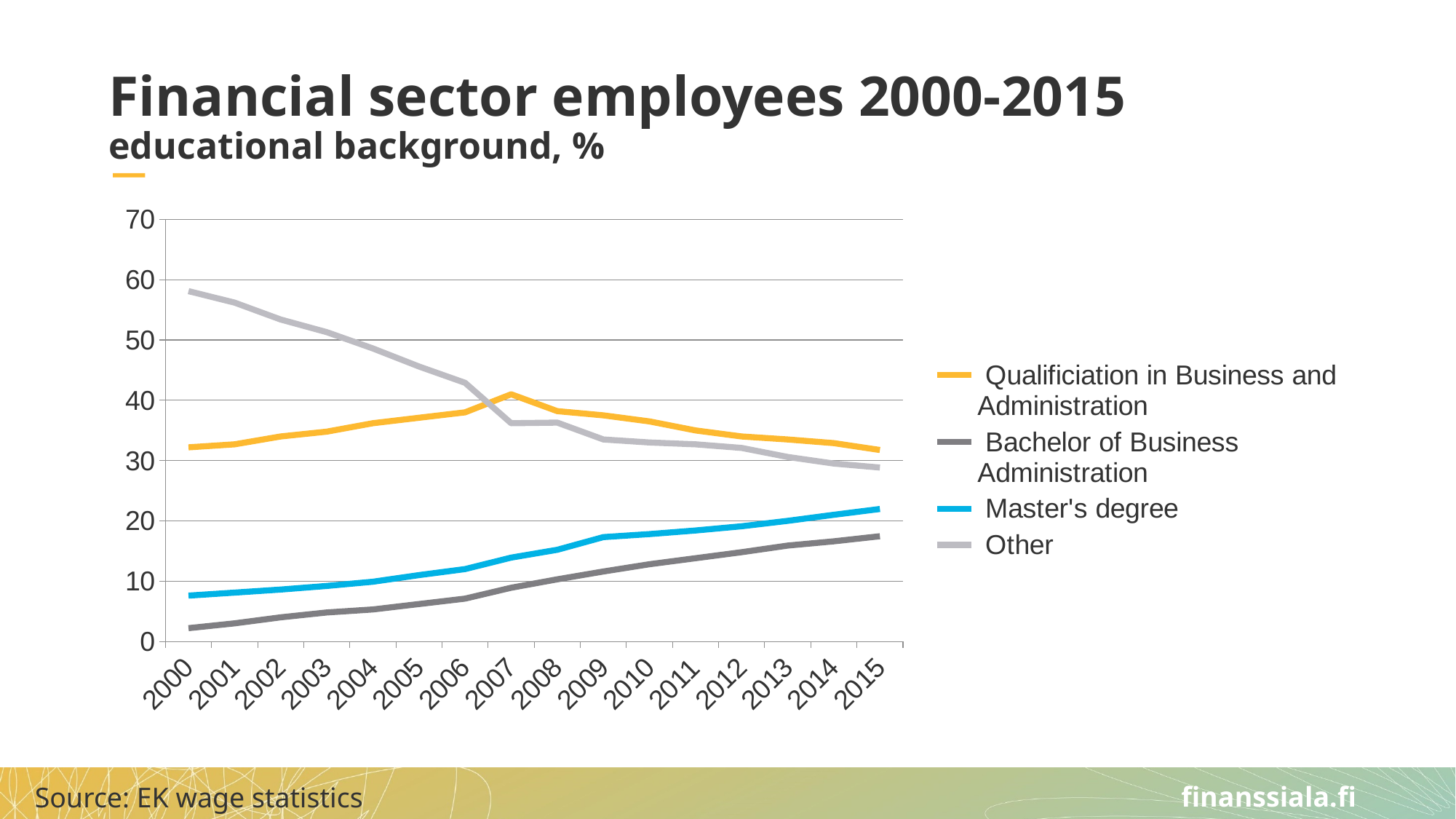
Which series has the lowest value in 2000? Bachelor of Business Administration Which series has the highest value in 2015? Qualificiation in Business and Administration What kind of chart is shown on the slide? line chart Which series has the highest value in 2000? Other In 2010, which is larger: Master's degree or Bachelor of Business Administration? Master's degree Is the value for Other in 2000 greater or less than 50? greater Is the value for Master's degree in 2015 greater or less than 20? greater How many series does the legend list? 4 Does the Other series rise or fall from 2000 to 2015? fall Does the Master's degree series rise or fall from 2000 to 2015? rise Is the value for Bachelor of Business Administration in 2000 greater or less than 10? less How many years are plotted along the x axis? 16